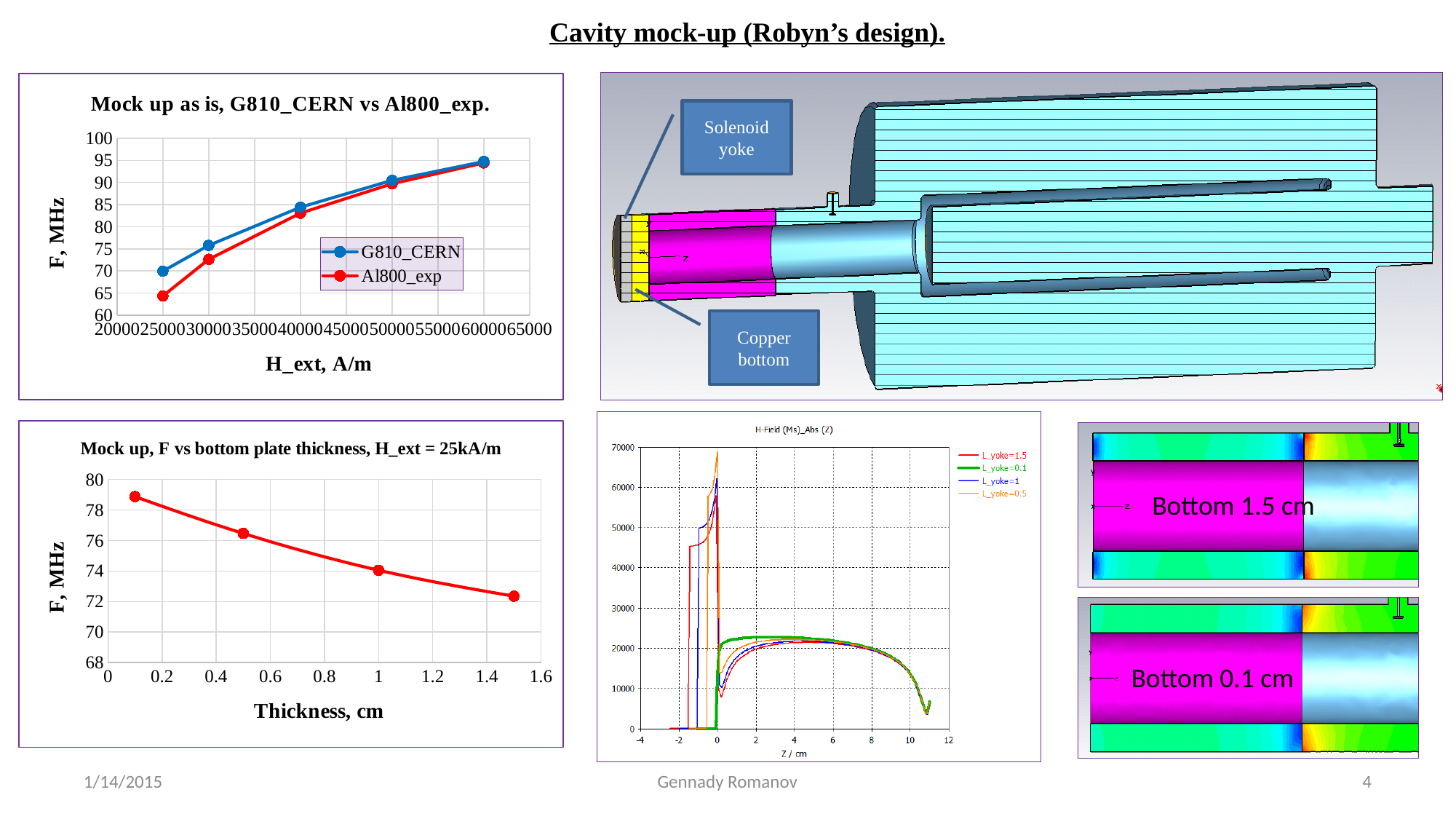
In the chart titled "Mock up as is, G810_CERN vs Al800_exp.", how many series does the legend list? 2 In the chart titled "Mock up, F vs bottom plate thickness, H_ext = 25kA/m", is the value at thickness 1.5 cm greater or less than 74 MHz? less In the chart titled "Mock up as is, G810_CERN vs Al800_exp.", is the Al800_exp value at H_ext = 30000 A/m greater or less than 75 MHz? less In the chart titled "Mock up as is, G810_CERN vs Al800_exp.", how many data points does the G810_CERN series have? 5 In the chart titled "Mock up, F vs bottom plate thickness, H_ext = 25kA/m", at which thickness is F highest? 0.1 cm In the chart titled "H-Field (Ms)_Abs (Z)", how many series does the legend list? 4 In the chart titled "Mock up, F vs bottom plate thickness, H_ext = 25kA/m", how many data points are plotted? 4 In the chart titled "Mock up as is, G810_CERN vs Al800_exp.", do the values rise or fall as H_ext increases? rise In the chart titled "Mock up as is, G810_CERN vs Al800_exp.", what kind of chart is it? line chart In the chart titled "Mock up, F vs bottom plate thickness, H_ext = 25kA/m", do the values rise or fall as thickness increases? fall In the chart titled "Mock up as is, G810_CERN vs Al800_exp.", at H_ext = 25000 A/m, which series has the larger F value, G810_CERN or Al800_exp? G810_CERN In the chart titled "Mock up as is, G810_CERN vs Al800_exp.", is the G810_CERN value at H_ext = 25000 A/m greater or less than 65 MHz? greater